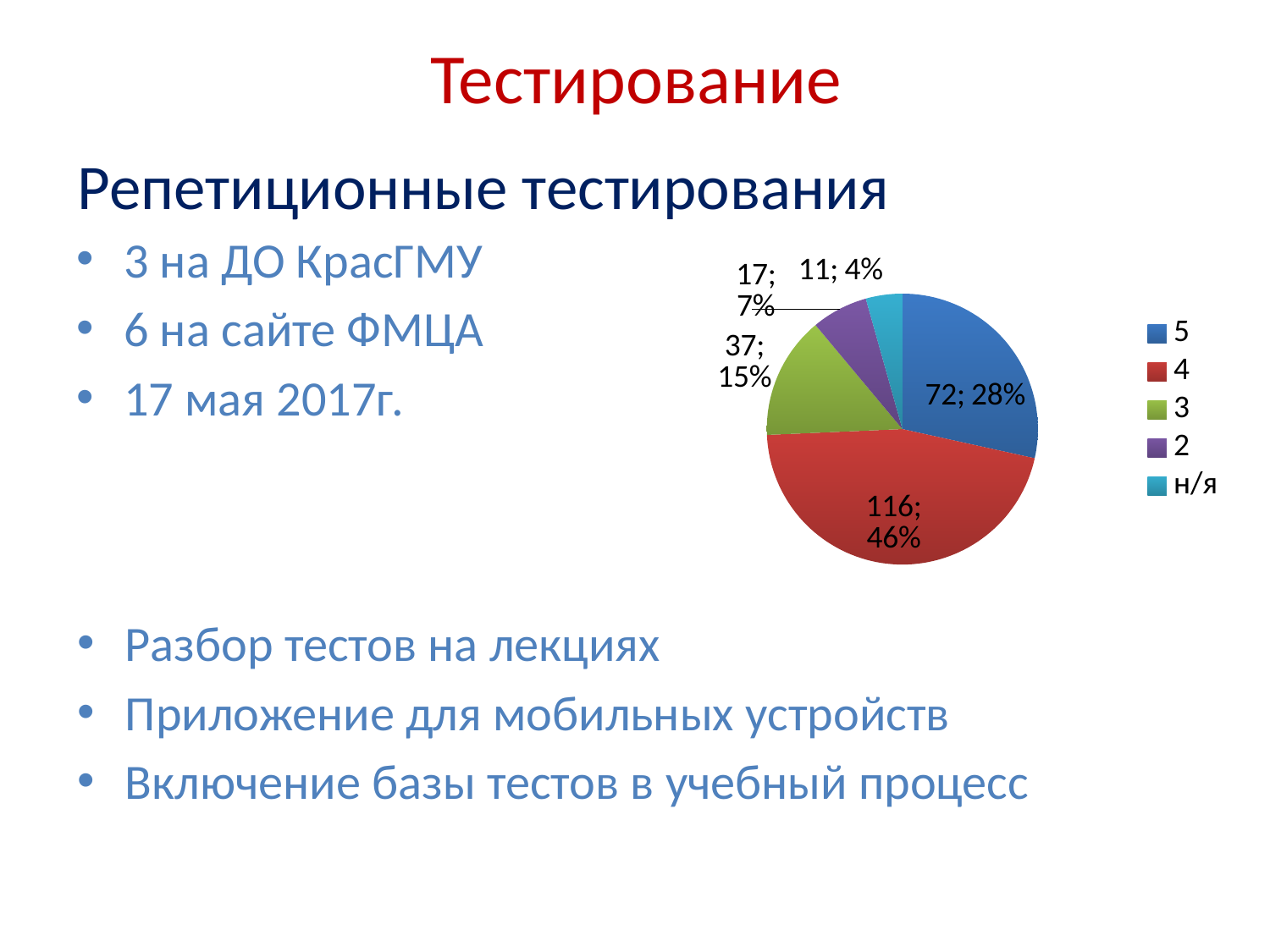
What is the difference between the values for slices 4 and 5 in the pie chart? 44 What is the value shown for the slice labelled н/я in the pie chart? 11 What is the value shown for the slice labelled 3 in the pie chart? 37 What kind of chart is shown on the slide? pie chart How many entries does the legend of the pie chart list? 5 What share of the pie does the slice labelled 2 represent? 7% What share of the pie does the slice labelled 4 represent? 46% What is the value shown for the slice labelled 5 in the pie chart? 72 What is the value shown for the slice labelled 4 in the pie chart? 116 How many slices does the pie chart have? 5 Which slice of the pie chart is the smallest? н/я Which slice of the pie chart is the largest? 4